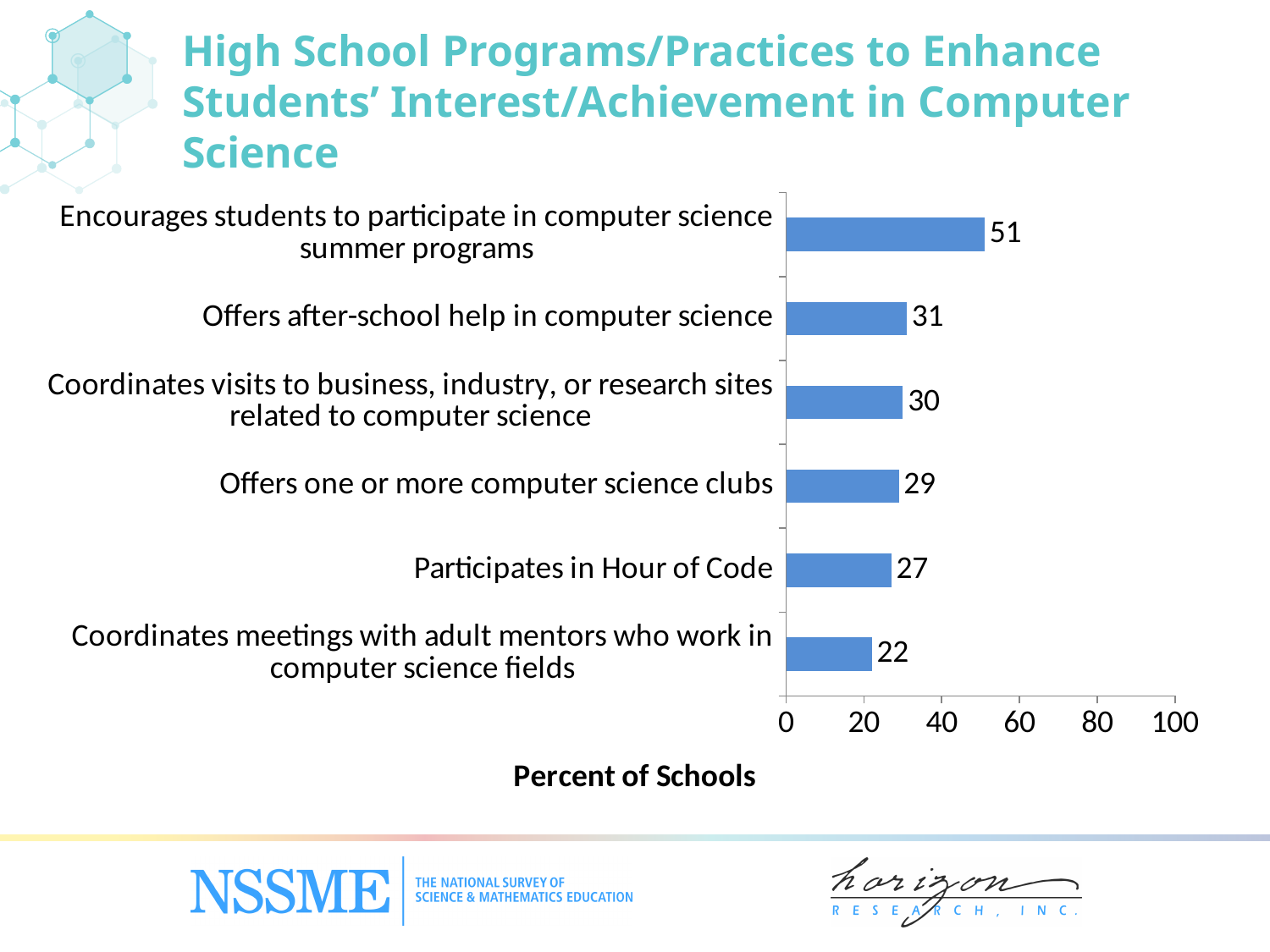
What kind of chart is shown on the slide? Bar chart Which program/practice has the lowest percent of schools? Coordinates meetings with adult mentors who work in computer science fields Which has a higher percent of schools: offering one or more computer science clubs or coordinating meetings with adult mentors who work in computer science fields? Offers one or more computer science clubs What percent of schools offer after-school help in computer science? 31 What percent of schools coordinate meetings with adult mentors who work in computer science fields? 22 What is the difference in percent of schools between encouraging participation in computer science summer programs and participating in Hour of Code? 24 How many programs/practices are shown in the chart? 6 What percent of schools participate in Hour of Code? 27 What is the label of the horizontal axis? Percent of Schools Is the value for coordinating visits to business, industry, or research sites related to computer science greater or less than 40? less What percent of schools encourage students to participate in computer science summer programs? 51 Which program/practice has the highest percent of schools? Encourages students to participate in computer science summer programs